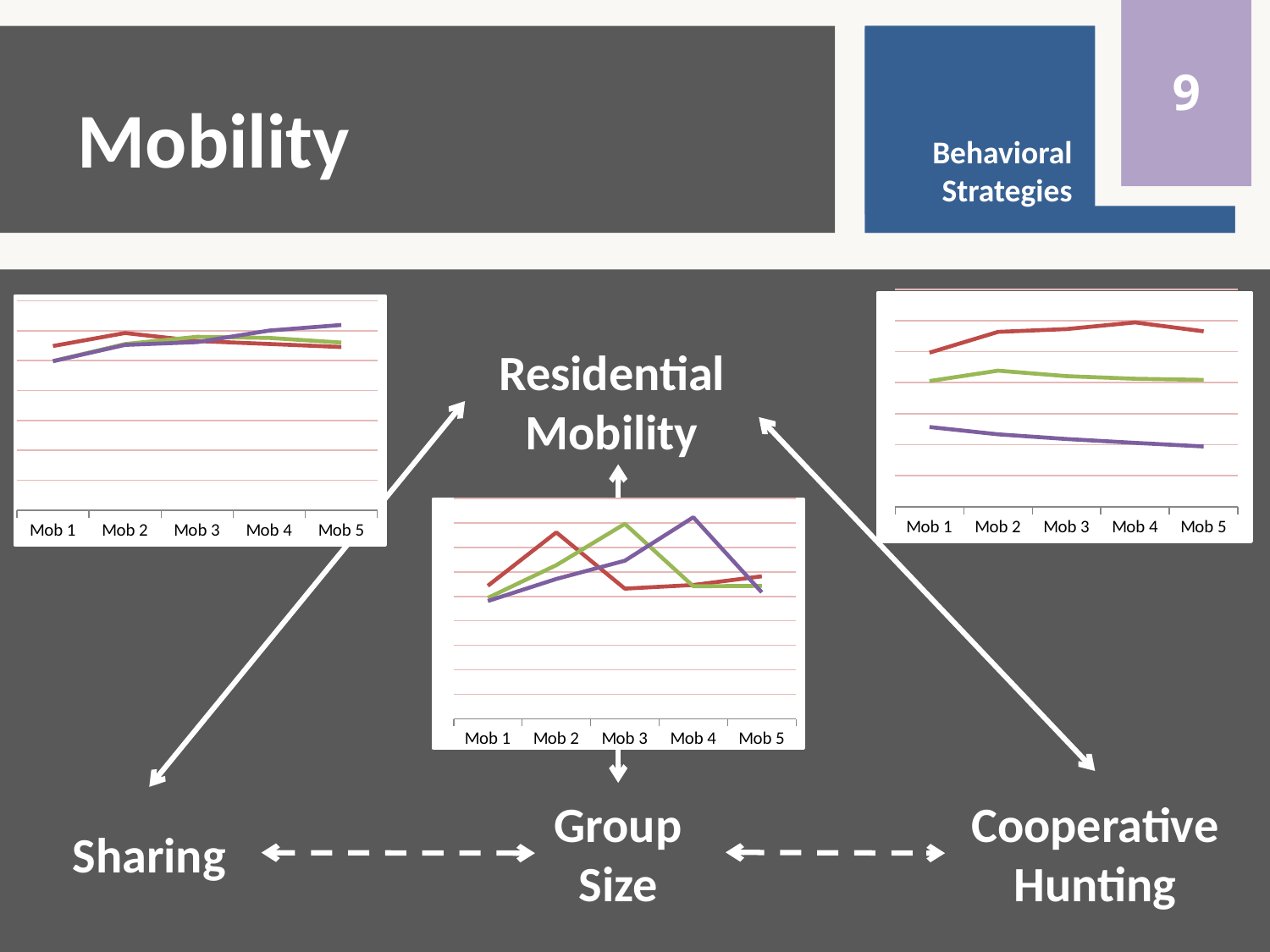
In the chart in the top-left of the slide, which line is higher at Mob 5: the purple line or the red line? Purple line In the chart in the centre of the slide, at which category does the green line reach its highest point? Mob 3 In the chart in the top-right of the slide, which line is lowest at Mob 5: the red line or the purple line? Purple line What is the label of the first category on the x axis of the chart in the top-right of the slide? Mob 1 What kind of chart is the chart in the top-left of the slide? Line chart In the chart in the top-right of the slide, does the purple line rise or fall from Mob 1 to Mob 5? Fall In the chart in the top-right of the slide, at which category does the red line reach its highest point? Mob 4 In the chart in the top-left of the slide, does the purple line rise or fall from Mob 1 to Mob 5? Rise How many categories are shown on the x axis of the chart in the centre of the slide? 5 How many lines are plotted on the chart in the top-right of the slide? 3 In the chart in the centre of the slide, at which category does the red line reach its highest point? Mob 2